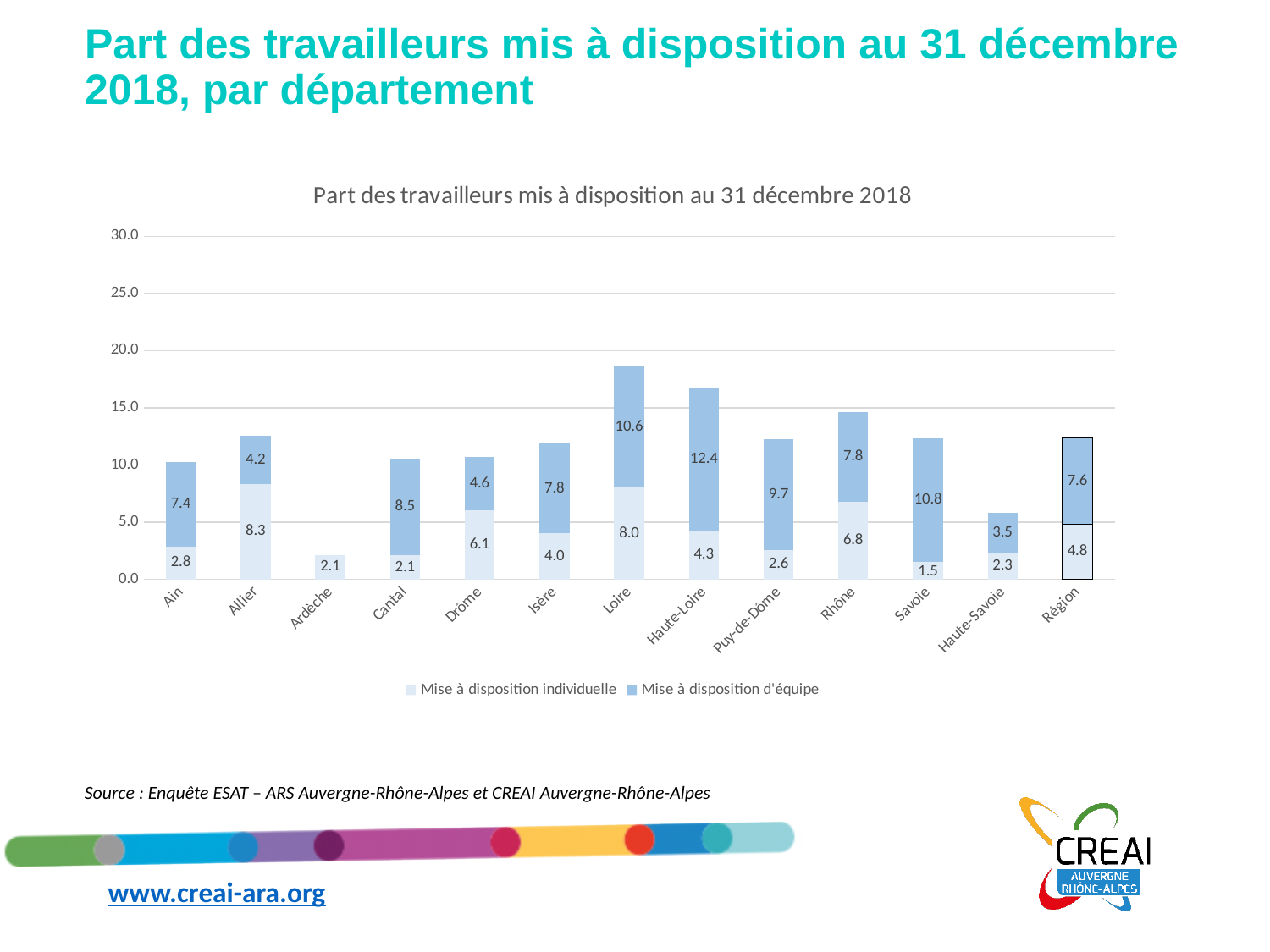
How many categories are shown on the x axis? 13 What is the value of 'Mise à disposition individuelle' for Région? 4.8 What is the value of 'Mise à disposition d'équipe' for Haute-Loire? 12.4 What is the total of the stacked bar for Loire? 18.6 What is the total of the stacked bar for Région? 12.4 Which is larger: 'Mise à disposition individuelle' for Drôme or for Rhône? Rhône What is the value of 'Mise à disposition individuelle' for Allier? 8.3 Which category has the tallest stacked bar overall? Loire Which département has the highest value for 'Mise à disposition d'équipe'? Haute-Loire Which category has the highest value for 'Mise à disposition individuelle'? Allier How many series does the legend list? 2 What is the difference between the 'Mise à disposition d'équipe' values for Savoie and Haute-Savoie? 7.3